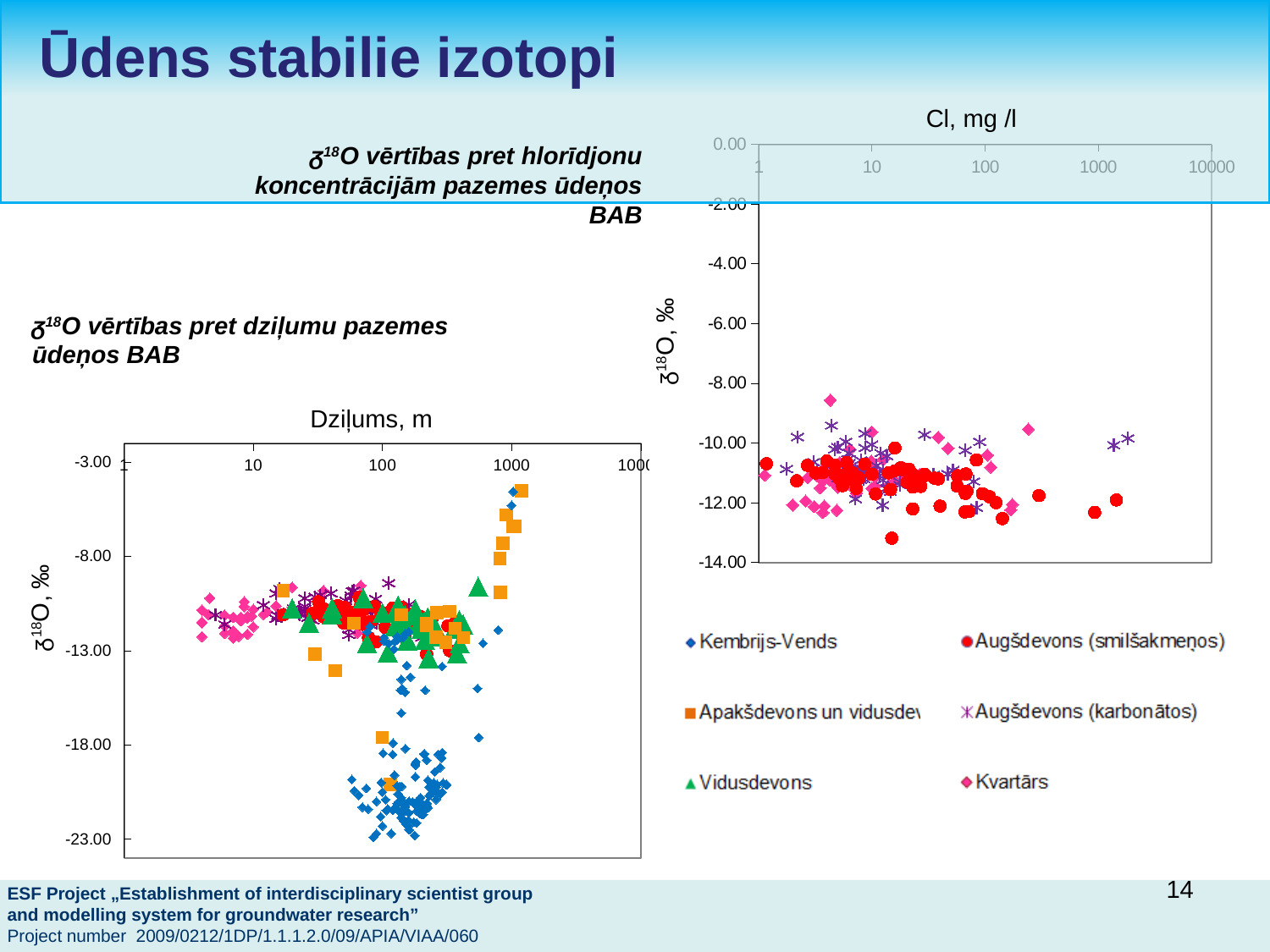
What is the x-axis title of the right-hand chart? Cl, mg /l What kind of chart is the chart on the right of the slide (δ18O against Cl, mg/l)? scatter chart In the right-hand chart, is the highest Kvartārs point greater or less than -10.00 ‰? greater What is the x-axis title of the left-hand chart? Dziļums, m In the right-hand chart, are the δ18O values of the Augšdevons (smilšakmeņos) points greater or less than -14.00? greater What is the lowest y-axis tick value shown on the left-hand chart? -23.00 What kind of chart is the chart on the left of the slide (δ18O against Dziļums, m)? scatter chart In the left-hand chart, is the δ18O value of the lowest cluster of Kembrijs-Vends points greater or less than -18.00? less How many series does the legend below the right-hand chart list? 6